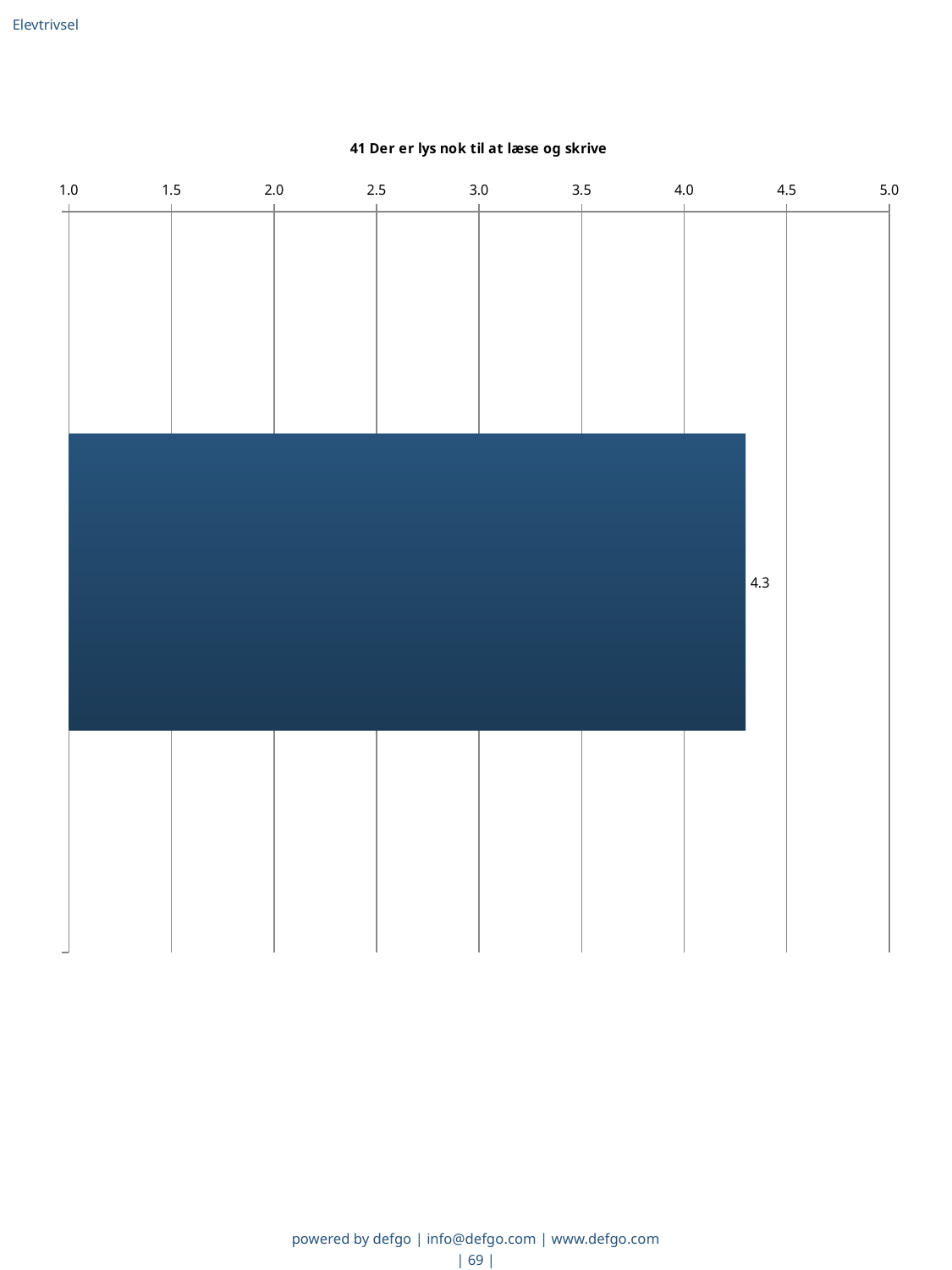
Is the bar in the chart horizontal or vertical? horizontal How many bars are plotted in the chart? 1 What kind of chart is shown on the slide? bar chart What is the value shown by the bar in the chart? 4.3 What is the highest value shown on the chart's axis? 5.0 Is the value of the bar greater or less than 4.0? greater Is the value of the bar greater or less than 4.5? less What is the title of the chart? 41 Der er lys nok til at læse og skrive